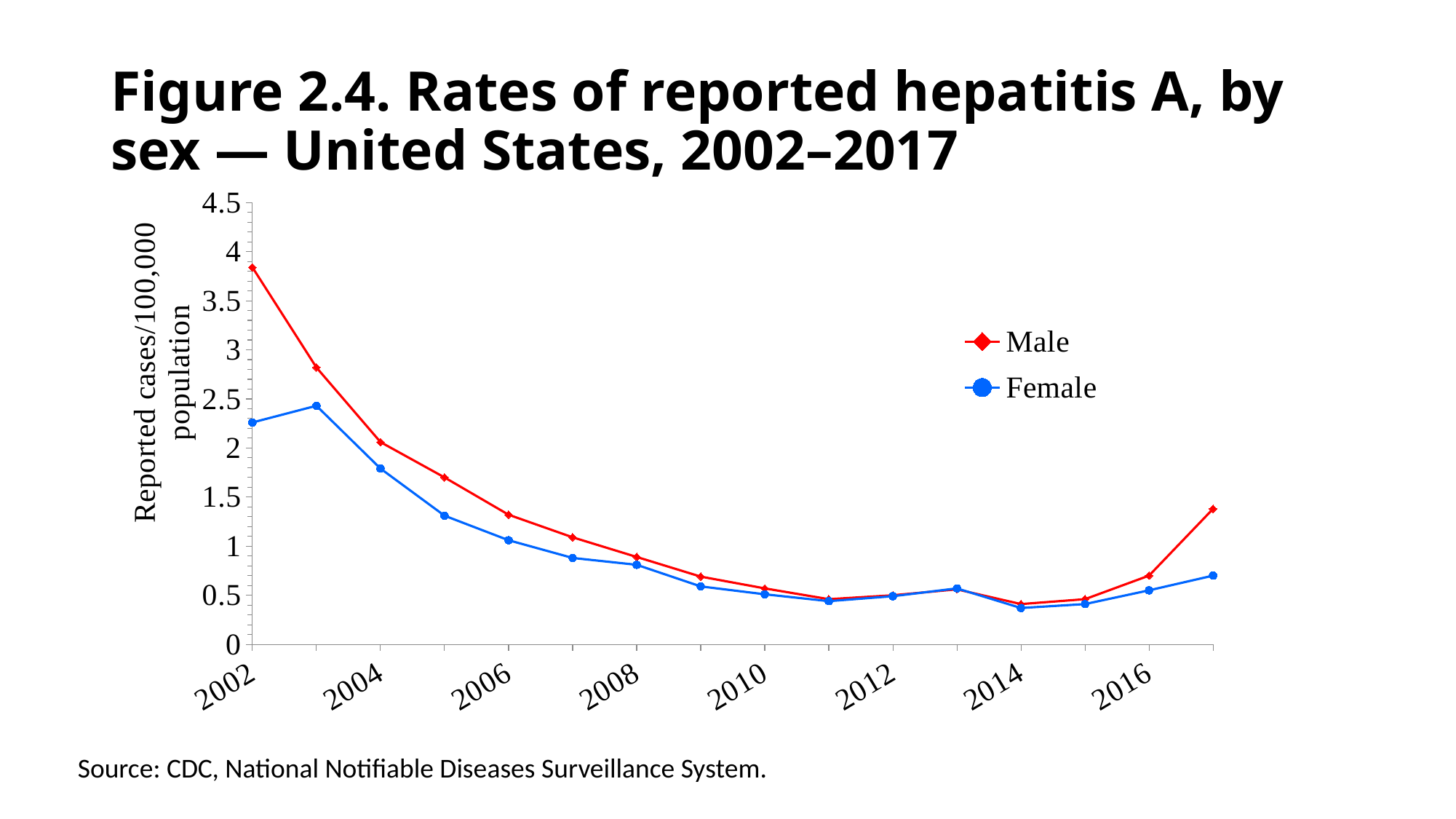
Is the Male value for 2006 greater or less than 1.5? less Do the Male and Female rates rise or fall from 2002 to 2010? Fall How many series does the legend list? 2 Is the Female value for 2014 greater or less than 0.5? less What is the y-axis label of the chart? Reported cases/100,000 population In 2002, which series has the higher rate, Male or Female? Male Which series is drawn in red? Male What kind of chart is shown on the slide? Line chart In which year does the Male series reach its highest value? 2002 Is the Female value for 2002 greater or less than 2? greater